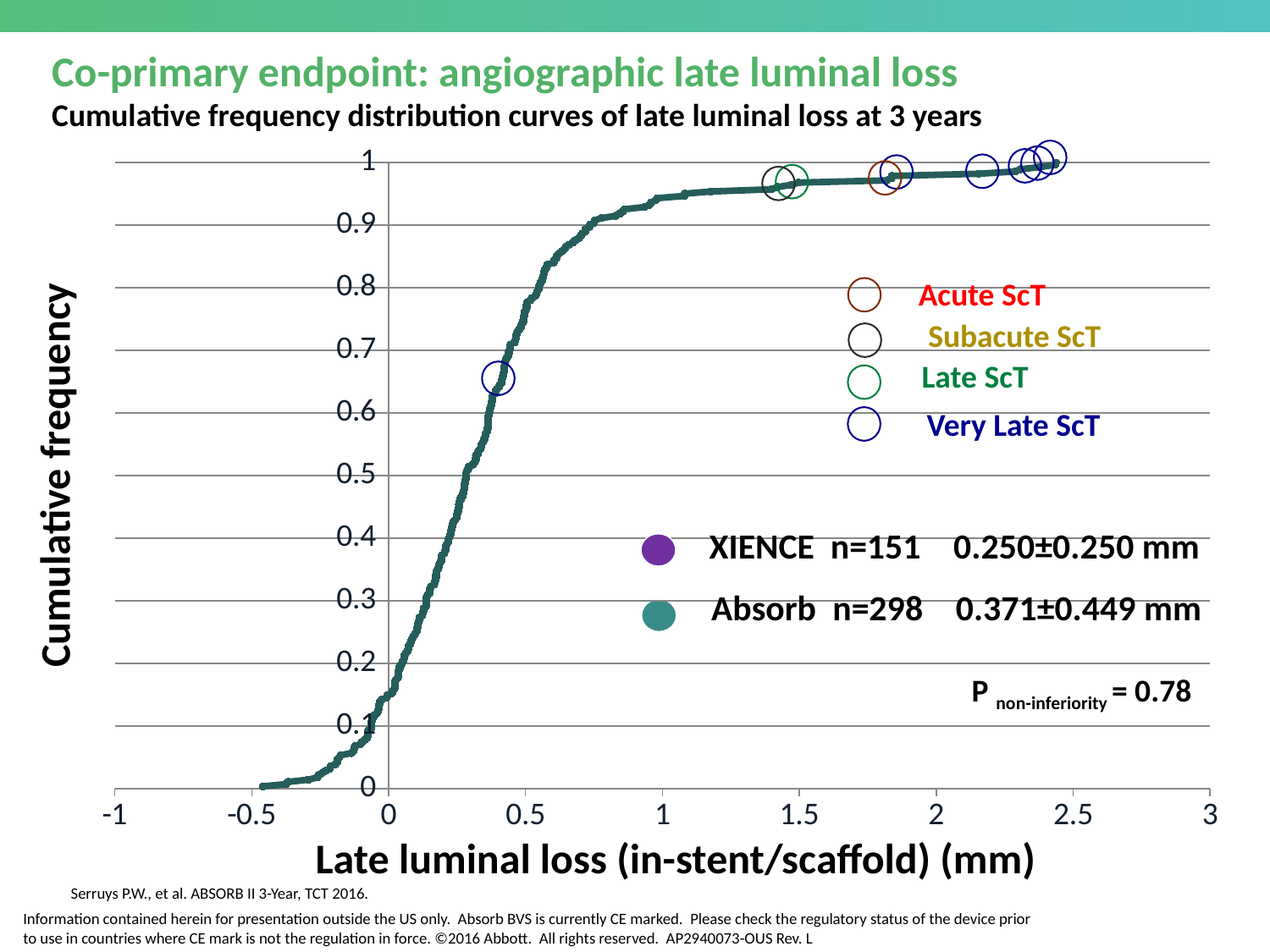
Which group has the larger mean late luminal loss, XIENCE or Absorb? Absorb Does the cumulative frequency curve rise or fall as late luminal loss increases along the x axis? rise What is the P value for non-inferiority shown on the chart? 0.78 What is the late luminal loss (mean ± SD) reported for XIENCE? 0.250±0.250 mm How many more patients are in the Absorb group than in the XIENCE group? 147 How many patients (n) are in the Absorb group according to the legend? 298 What is the late luminal loss (mean ± SD) reported for Absorb? 0.371±0.449 mm Is the cumulative frequency at a late luminal loss of 1 mm greater or less than 0.9? greater What is the label of the x axis? Late luminal loss (in-stent/scaffold) (mm) What is the title of the chart? Cumulative frequency distribution curves of late luminal loss at 3 years What kind of chart is shown on the slide? line chart How many patients (n) are in the XIENCE group according to the legend? 151